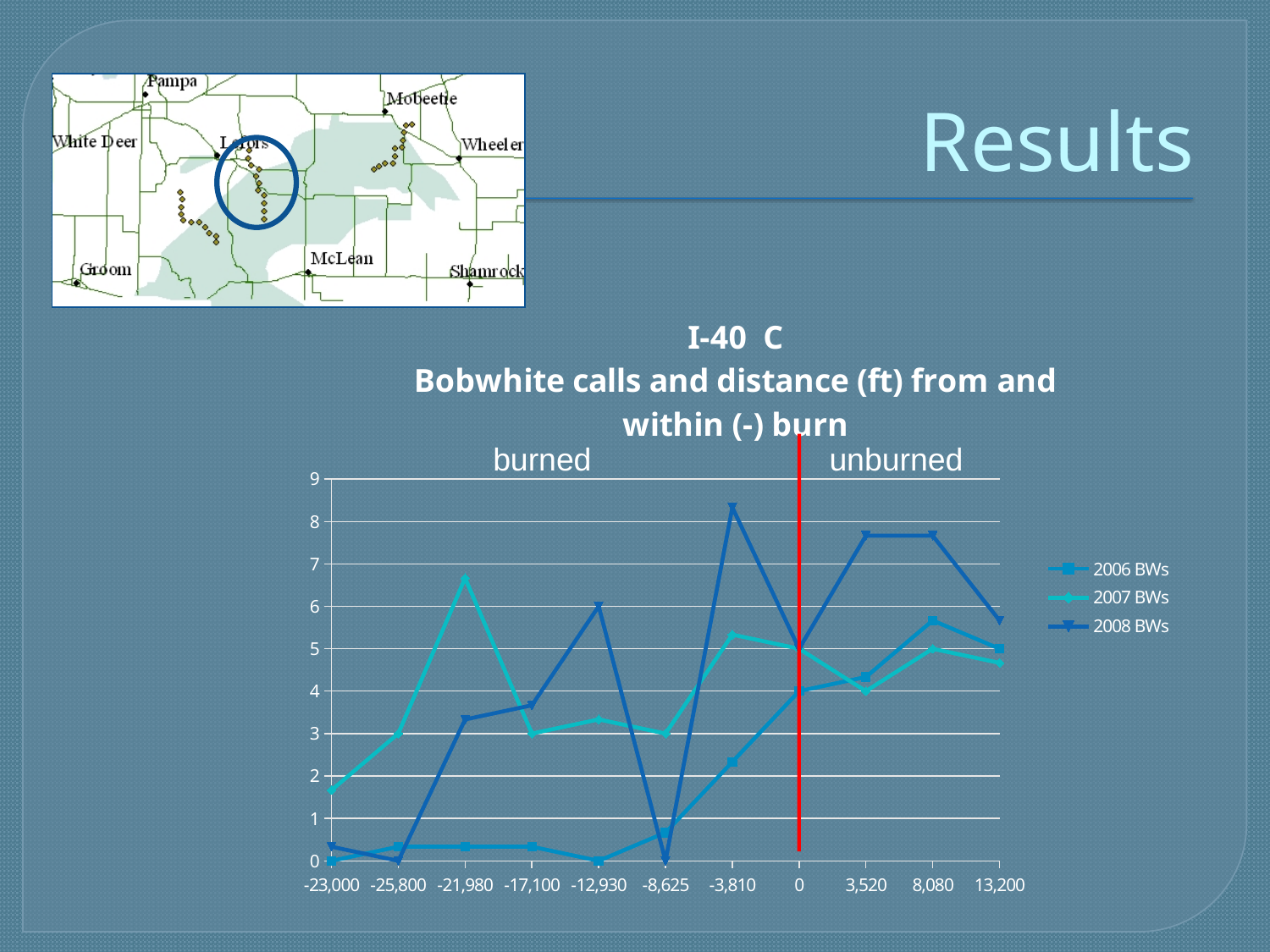
How many distance categories are shown on the x axis? 11 At -21,980, which series has the larger value, 2007 BWs or 2006 BWs? 2007 BWs Is the value for 2007 BWs at -21,980 greater or less than 6? greater What are the two region labels written above the plot area on either side of the red vertical line? burned and unburned At 3,520, which series has the larger value, 2008 BWs or 2006 BWs? 2008 BWs At which distance does the 2007 BWs series reach its highest value? -21,980 At which distance does the 2008 BWs series reach its highest value? -3,810 Is the value for 2008 BWs at -3,810 greater or less than 8? greater Does the 2006 BWs series generally rise or fall from -12,930 to 8,080? rise How many series does the legend list? 3 Is the value for 2006 BWs at -23,000 greater or less than 1? less What kind of chart is shown on the slide? line chart